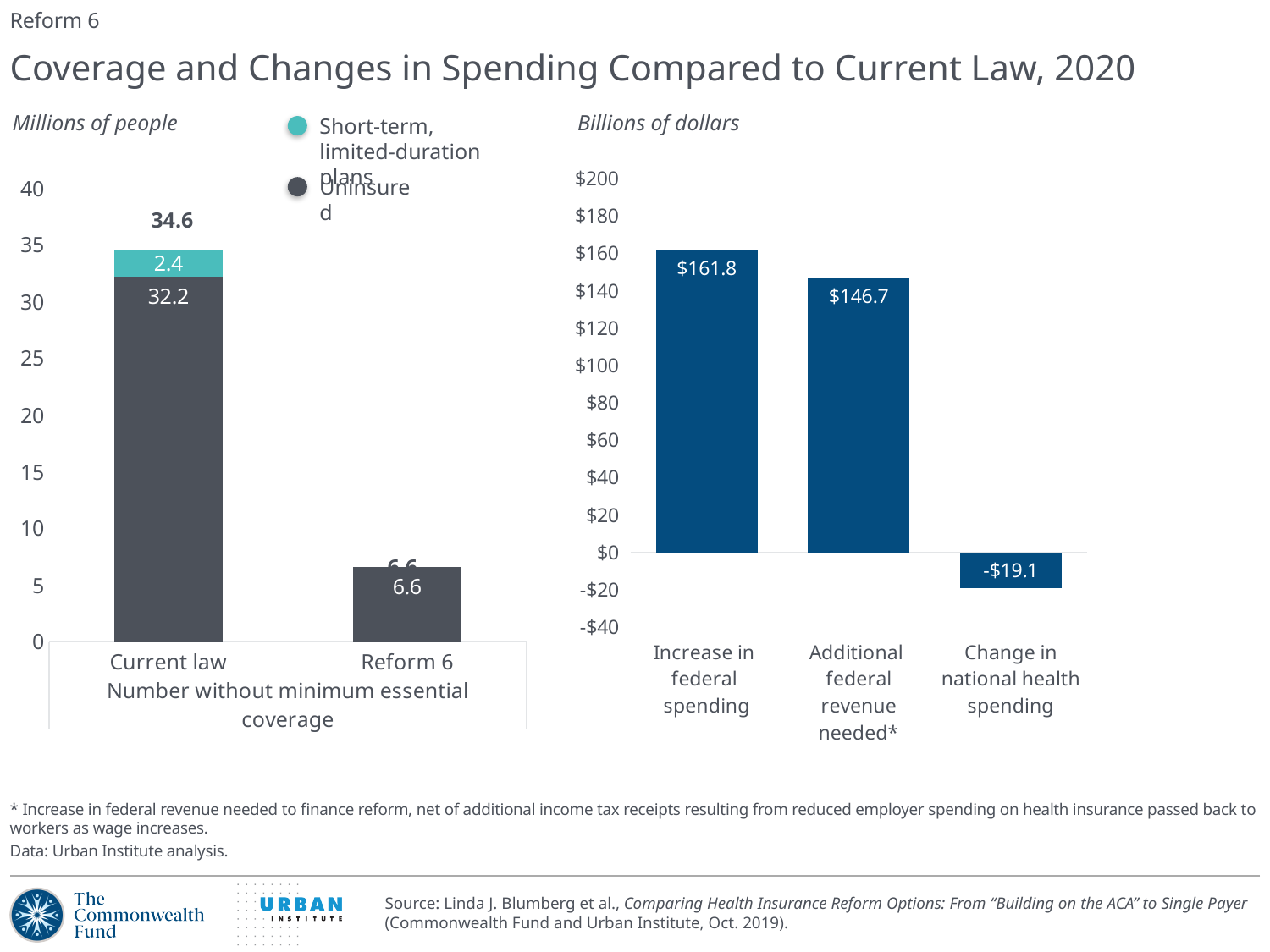
In the right chart (Billions of dollars), what is the value for Increase in federal spending? $161.8 In the right chart (Billions of dollars), what is the value for Additional federal revenue needed? $146.7 What kind of chart is the right chart (Billions of dollars)? Bar chart In the left chart (Millions of people), how many series does the legend list? 2 In the right chart (Billions of dollars), what is the difference between Increase in federal spending and Additional federal revenue needed? $15.1 In the left chart (Millions of people), what is the Uninsured value for Reform 6? 6.6 In the left chart (Millions of people), what is the Short-term, limited-duration plans value for Current law? 2.4 In the right chart (Billions of dollars), what is the value for Change in national health spending? -$19.1 In the left chart (Millions of people), what is the total of the Current law stacked bar? 34.6 In the left chart (Millions of people), what is the Uninsured value for Current law? 32.2 In the right chart (Billions of dollars), which category has the highest value? Increase in federal spending In the left chart (Millions of people), what is the difference between the Uninsured values for Current law and Reform 6? 25.6